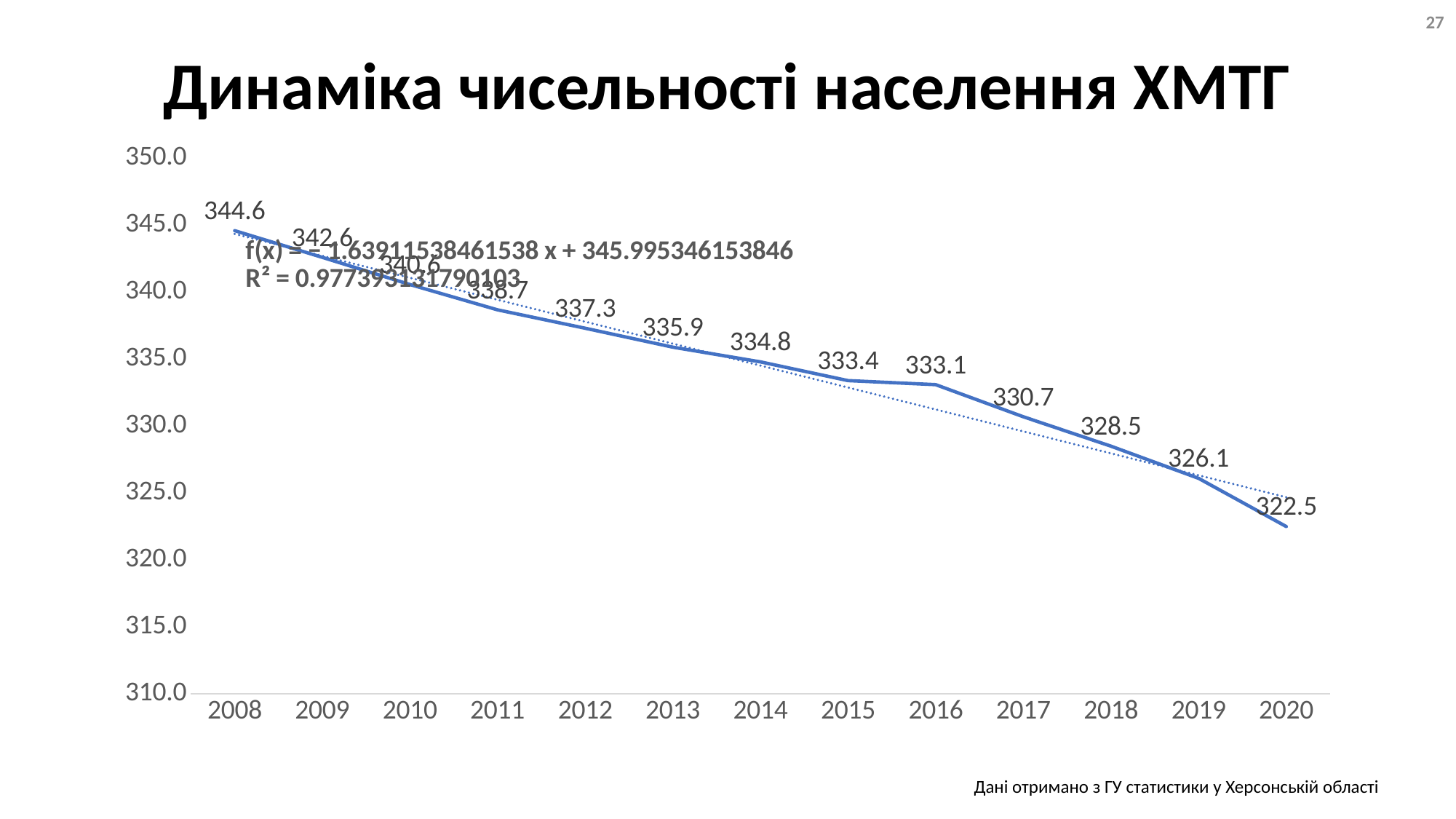
What is the value for 2016? 333.1 Which year has the highest value? 2008 How many years are plotted on the x axis? 13 Which year has the lowest value? 2020 Which is larger, the value for 2017 or the value for 2019? 2017 What is the title of the chart? Динаміка чисельності населення ХМТГ What is the value for 2013? 335.9 Do the values rise or fall from 2008 to 2020? fall What is the difference between the values for 2008 and 2020? 22.1 What type of chart is shown on the slide? line chart What is the value for 2020? 322.5 What is the value for 2008? 344.6